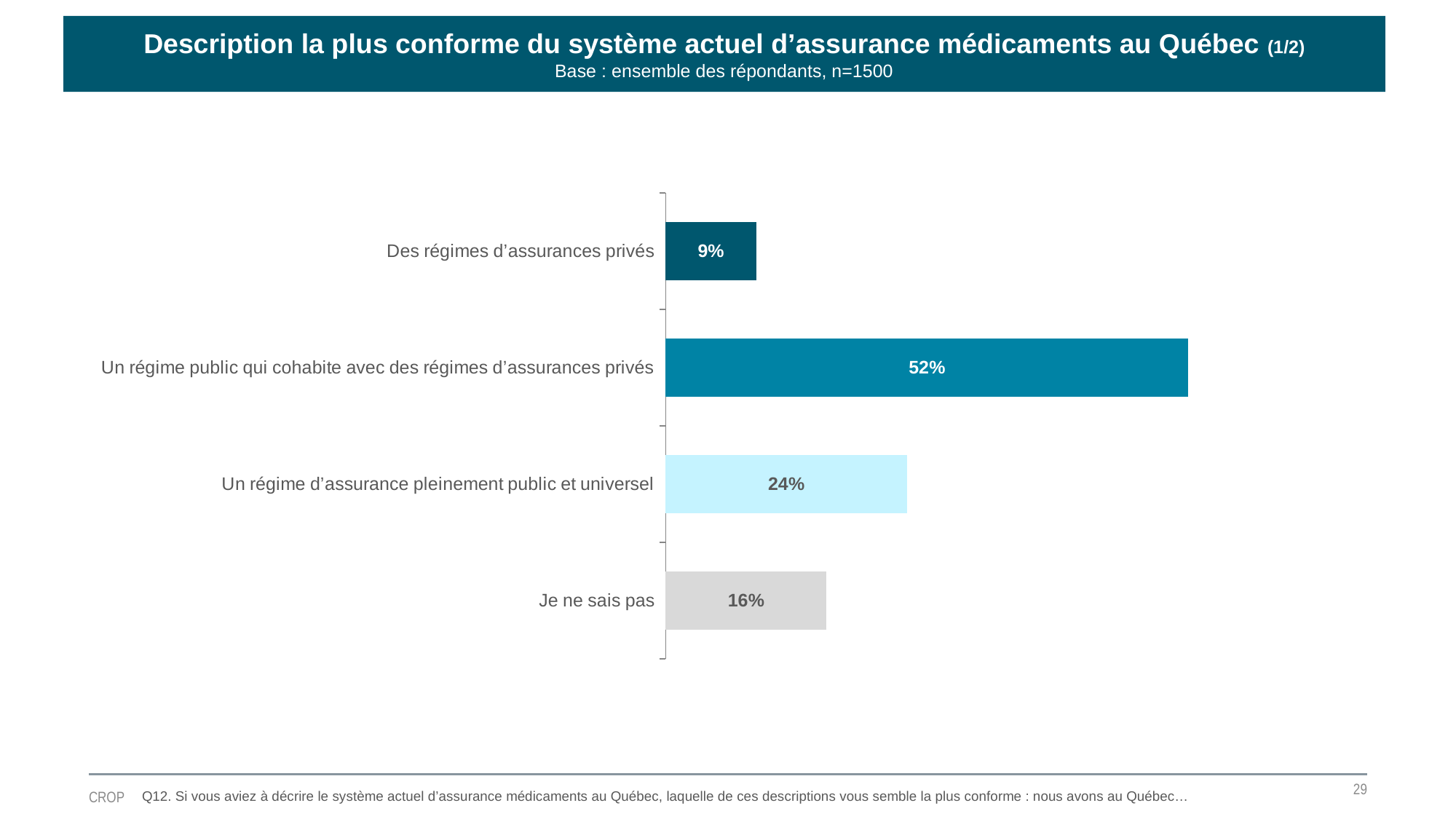
What is the base (number of respondents) stated under the chart title? n=1500 What is the difference between "Je ne sais pas" and "Des régimes d'assurances privés"? 7% How many categories are shown in the chart? 4 Which category has the highest value? Un régime public qui cohabite avec des régimes d'assurances privés What percentage of respondents chose "Un régime public qui cohabite avec des régimes d'assurances privés"? 52% Which category has the lowest value? Des régimes d'assurances privés What is the value shown for "Des régimes d'assurances privés"? 9% What is the difference between the values for "Un régime public qui cohabite avec des régimes d'assurances privés" and "Un régime d'assurance pleinement public et universel"? 28% Which is larger: the value for "Un régime d'assurance pleinement public et universel" or for "Je ne sais pas"? Un régime d'assurance pleinement public et universel What percentage is shown for "Un régime d'assurance pleinement public et universel"? 24% What is the value for "Je ne sais pas"? 16% What kind of chart is shown on the slide? Bar chart